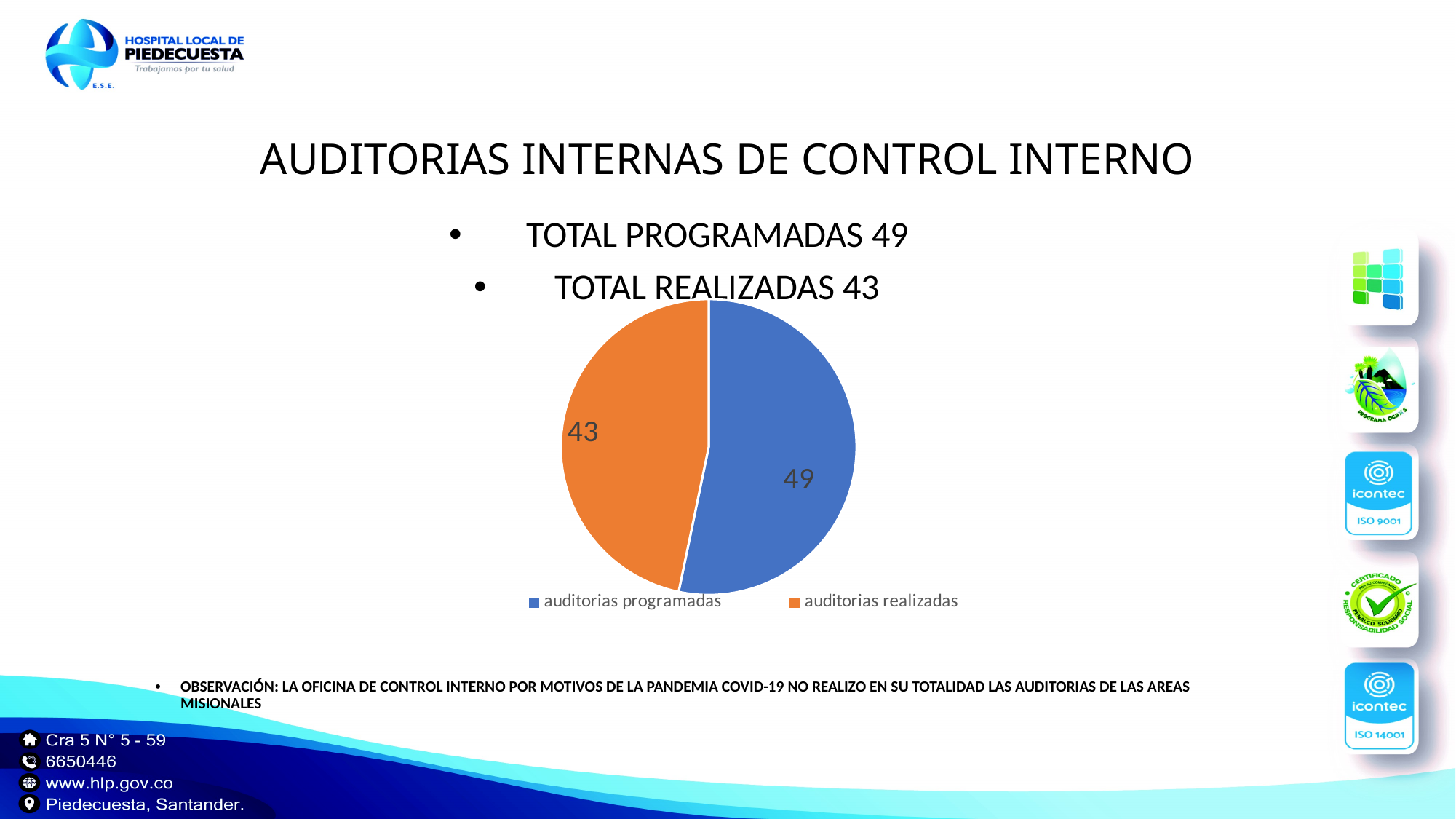
How many entries does the legend of the pie chart list? 2 What is the value for auditorias programadas in the pie chart? 49 Which is larger, auditorias programadas or auditorias realizadas? auditorias programadas What colour is the auditorias realizadas slice in the pie chart? orange Which slice of the pie chart is the smallest? auditorias realizadas What type of chart is shown on the slide? pie chart What is the difference between auditorias programadas and auditorias realizadas? 6 Which slice of the pie chart is the largest? auditorias programadas What is the value for auditorias realizadas in the pie chart? 43 What is the total of the two values shown in the pie chart? 92 How many slices does the pie chart have? 2 What colour is the auditorias programadas slice in the pie chart? blue